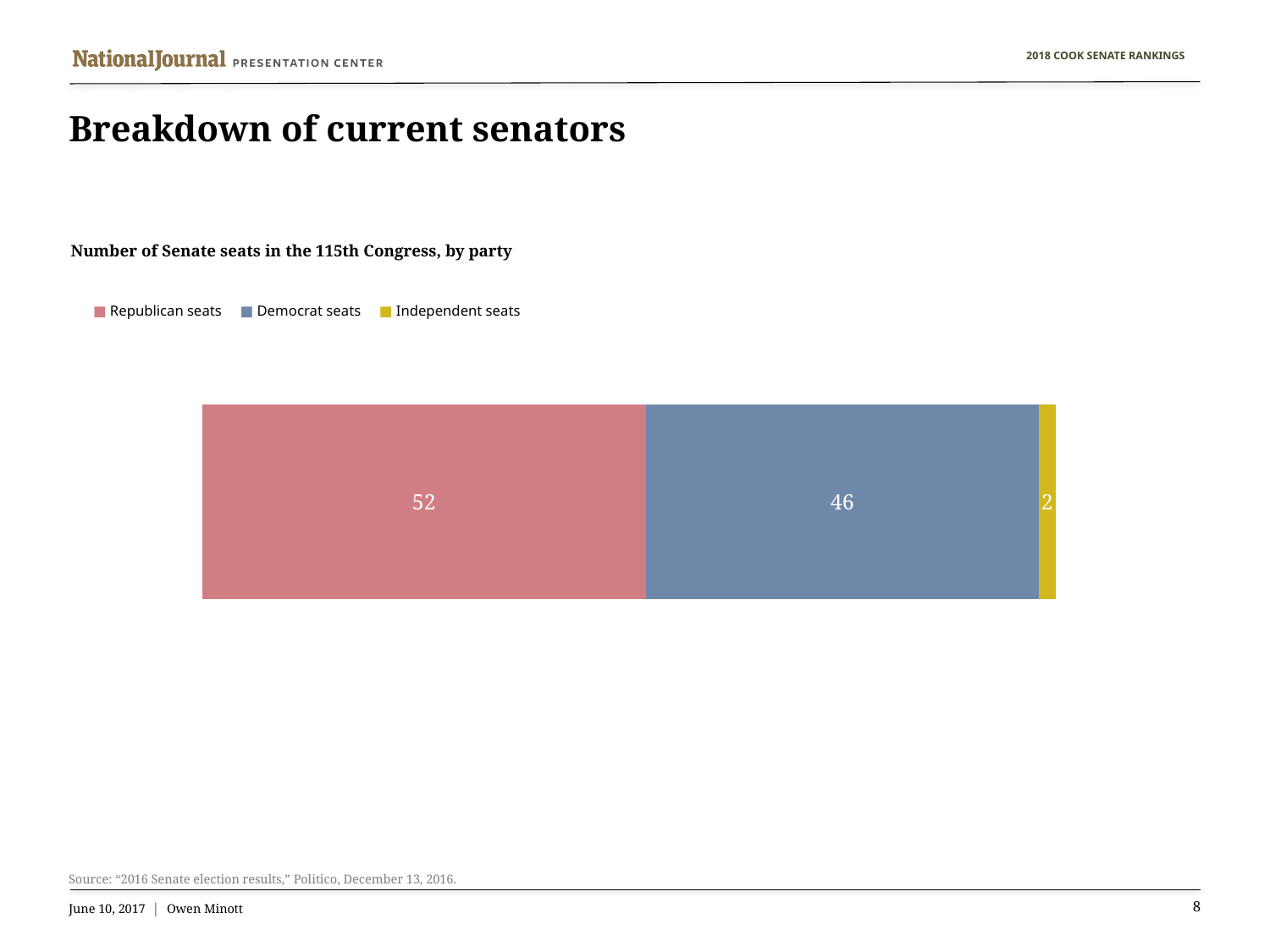
How many series does the legend list? 3 What kind of chart is shown on the slide? Stacked bar chart Which is larger, Democrat seats or Independent seats? Democrat seats Which party has the fewest Senate seats in the chart? Independent seats What is the difference between Republican seats and Democrat seats? 6 How many Independent seats does the chart show? 2 How many Democrat seats does the chart show? 46 Which party has the most Senate seats in the chart? Republican seats How many Republican seats does the chart show? 52 What colour represents Independent seats in the chart? Yellow What is the total number of seats shown in the stacked bar? 100 What is the title of the chart? Number of Senate seats in the 115th Congress, by party